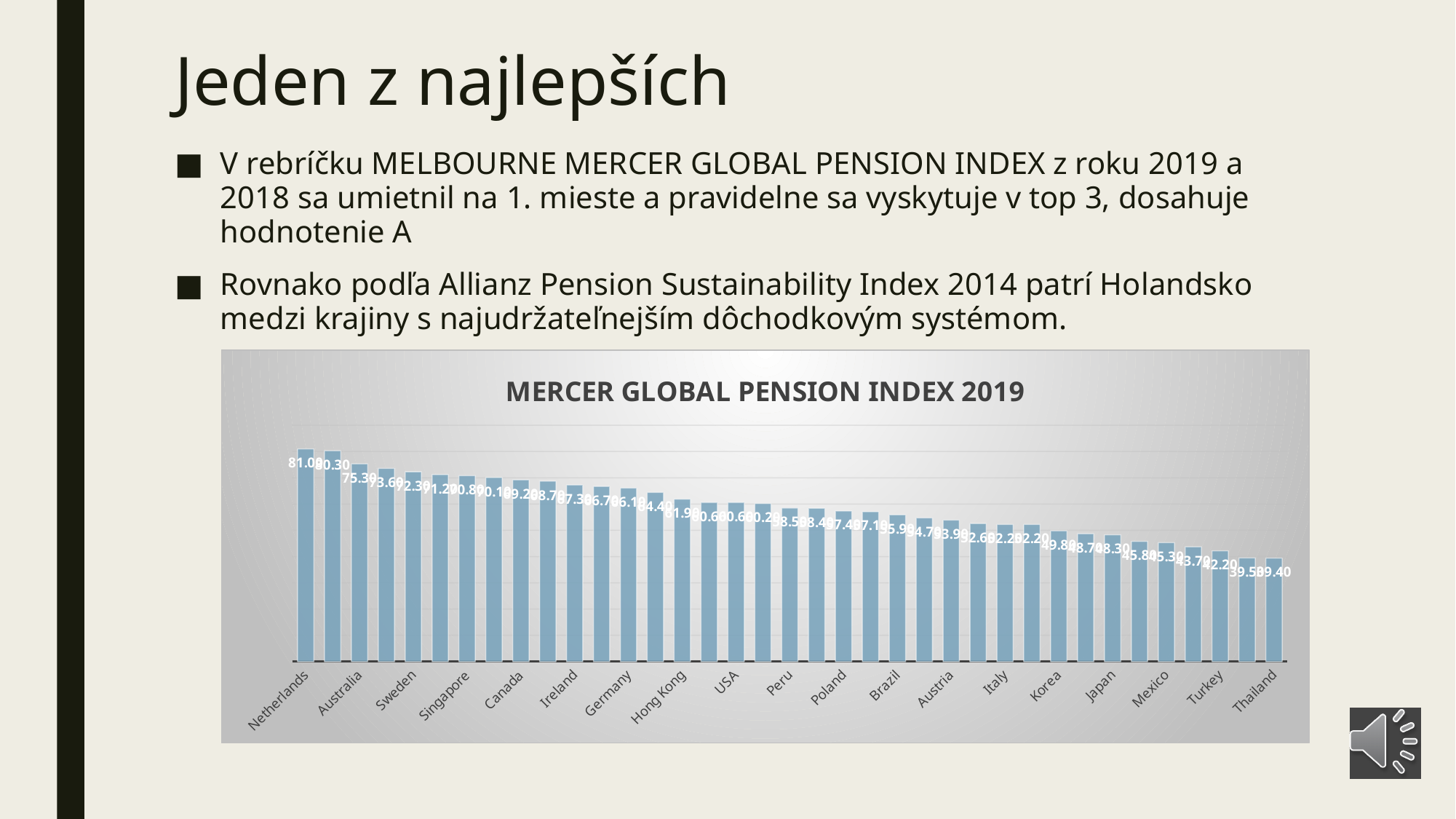
What is the difference between the values for Netherlands and Thailand in the chart? 41.60 What is the value for Australia in the chart? 75.30 Which has a larger value in the chart, Netherlands or Thailand? Netherlands What is the value for Thailand in the chart? 39.40 What kind of chart is shown on the slide? bar chart What is the difference between the values for Netherlands and Australia in the chart? 5.70 What is the value for Netherlands in the chart? 81.00 Which country has the highest value in the MERCER GLOBAL PENSION INDEX 2019 chart? Netherlands Which has a larger value in the chart, Australia or Japan? Australia What is the title of the chart on the slide? MERCER GLOBAL PENSION INDEX 2019 Which country has the lowest value in the MERCER GLOBAL PENSION INDEX 2019 chart? Thailand Do the values in the chart rise or fall from left to right along the x axis? fall